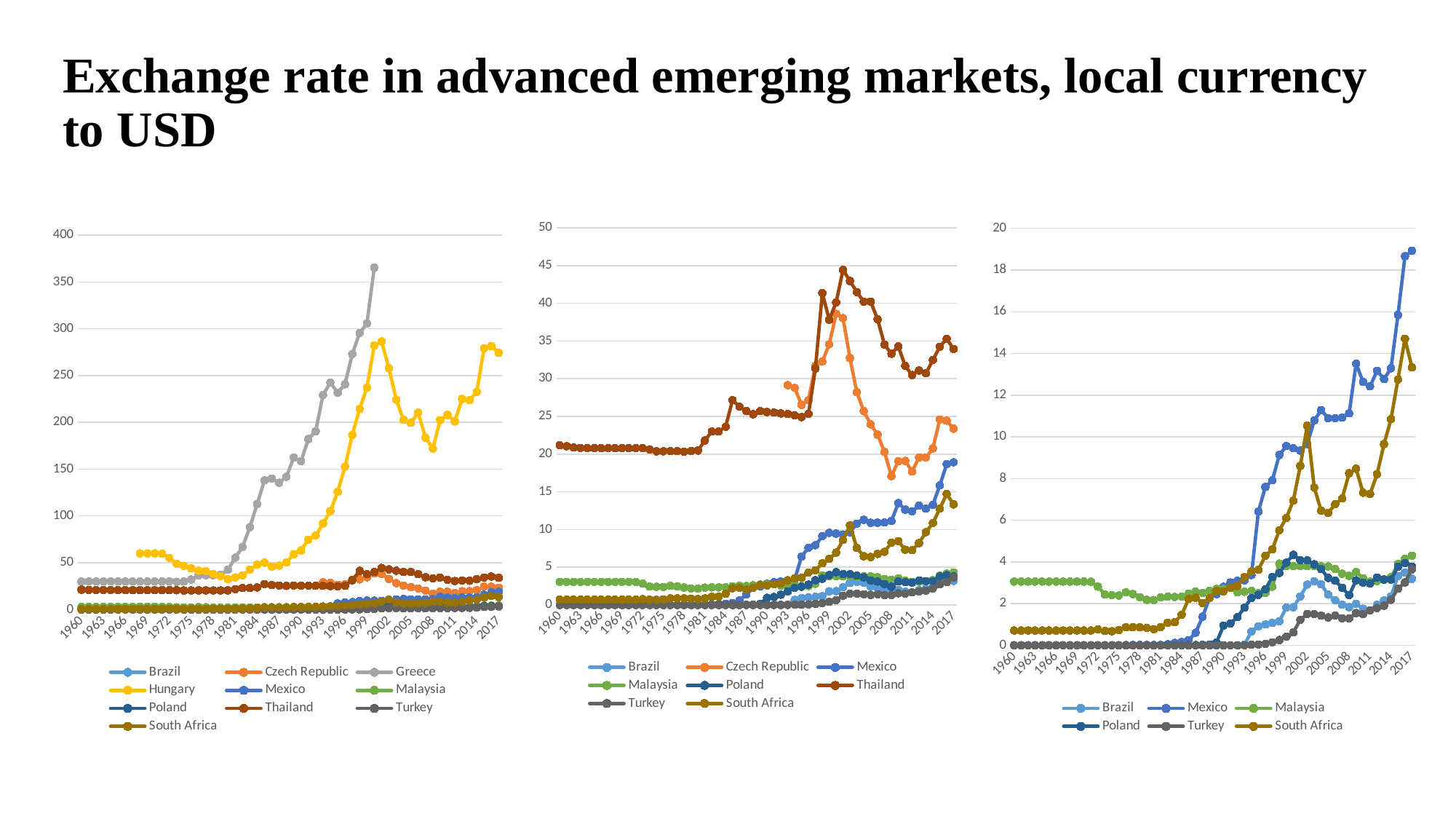
What kind of chart is the left chart on the slide? line chart In the right chart, which series reaches the highest value? Mexico In the middle chart, which series reaches the highest value? Thailand How many series does the legend of the left chart list? 10 In the middle chart, is the highest value reached by Thailand greater or less than 40? greater In the left chart, is the highest value reached by Greece greater or less than 350? greater How many series does the legend of the right chart list? 6 In the right chart, is the value for Mexico in 2017 greater or less than 18? greater In the right chart, does the value for Mexico rise or fall from 1990 to 2017? rise In the left chart, which series is higher in 2017, Hungary or Thailand? Hungary How many series does the legend of the middle chart list? 8 What is the first year shown on the x axis of the left chart? 1960